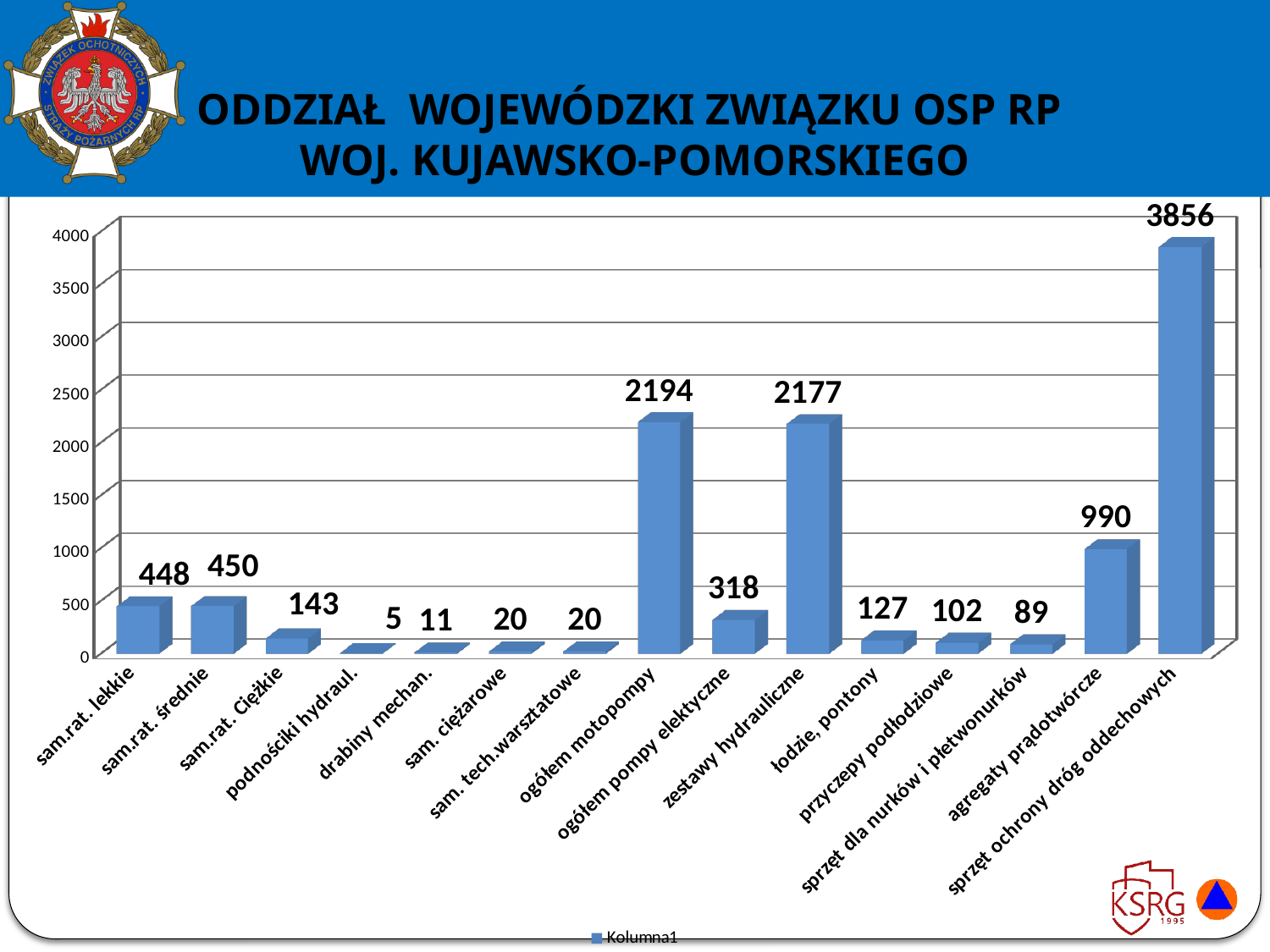
What is the value for 'agregaty prądotwórcze'? 990 Which is larger, the value for 'łodzie, pontony' or the value for 'przyczepy podłodziowe'? łodzie, pontony Which category has the lowest value? podnościki hydraul. What is the value for 'sam.rat. Ciężkie'? 143 Which category has the highest value? sprzęt ochrony dróg oddechowych What kind of chart is shown on the slide? bar chart What is the difference between the values for 'sprzęt ochrony dróg oddechowych' and 'agregaty prądotwórcze'? 2866 How many categories are shown on the x axis? 15 What is the name of the series listed in the legend? Kolumna1 Is the value for 'ogółem pompy elektyczne' greater or less than 500? less What is the value for 'ogółem motopompy'? 2194 What is the difference between the values for 'ogółem motopompy' and 'zestawy hydrauliczne'? 17